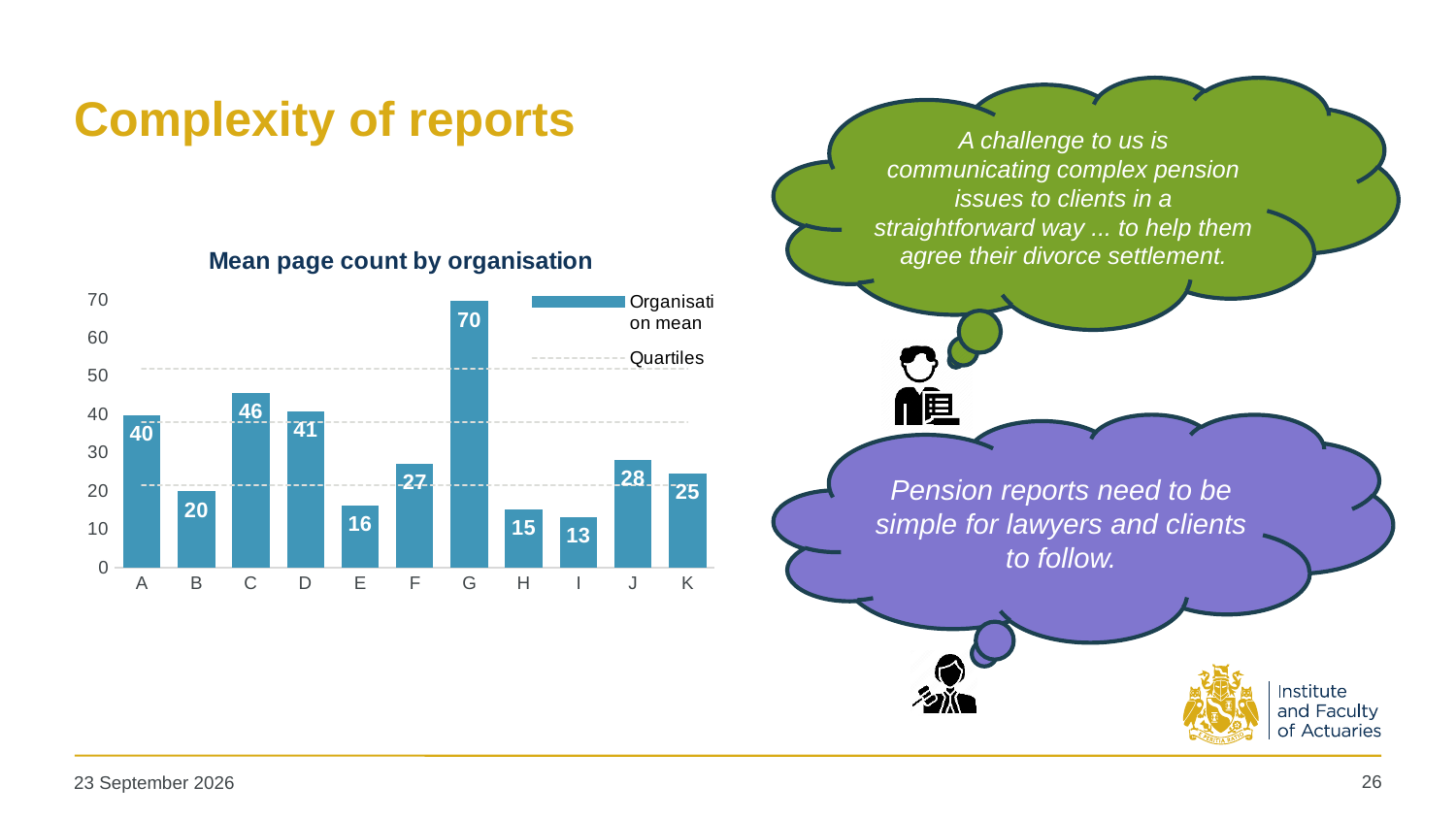
Is the mean page count for organisation F greater or less than 30? less How many organisations are shown on the x axis of the chart? 11 Which organisation has the highest mean page count? G What is the mean page count for organisation K? 25 What is the difference in mean page count between organisations G and I? 57 Which has a higher mean page count, organisation D or organisation J? D What type of chart is used to show mean page count by organisation? bar chart How many entries does the chart legend list? 2 What is the mean page count for organisation C? 46 What is the mean page count for organisation G? 70 Which organisation has the lowest mean page count? I What is the title of the chart? Mean page count by organisation